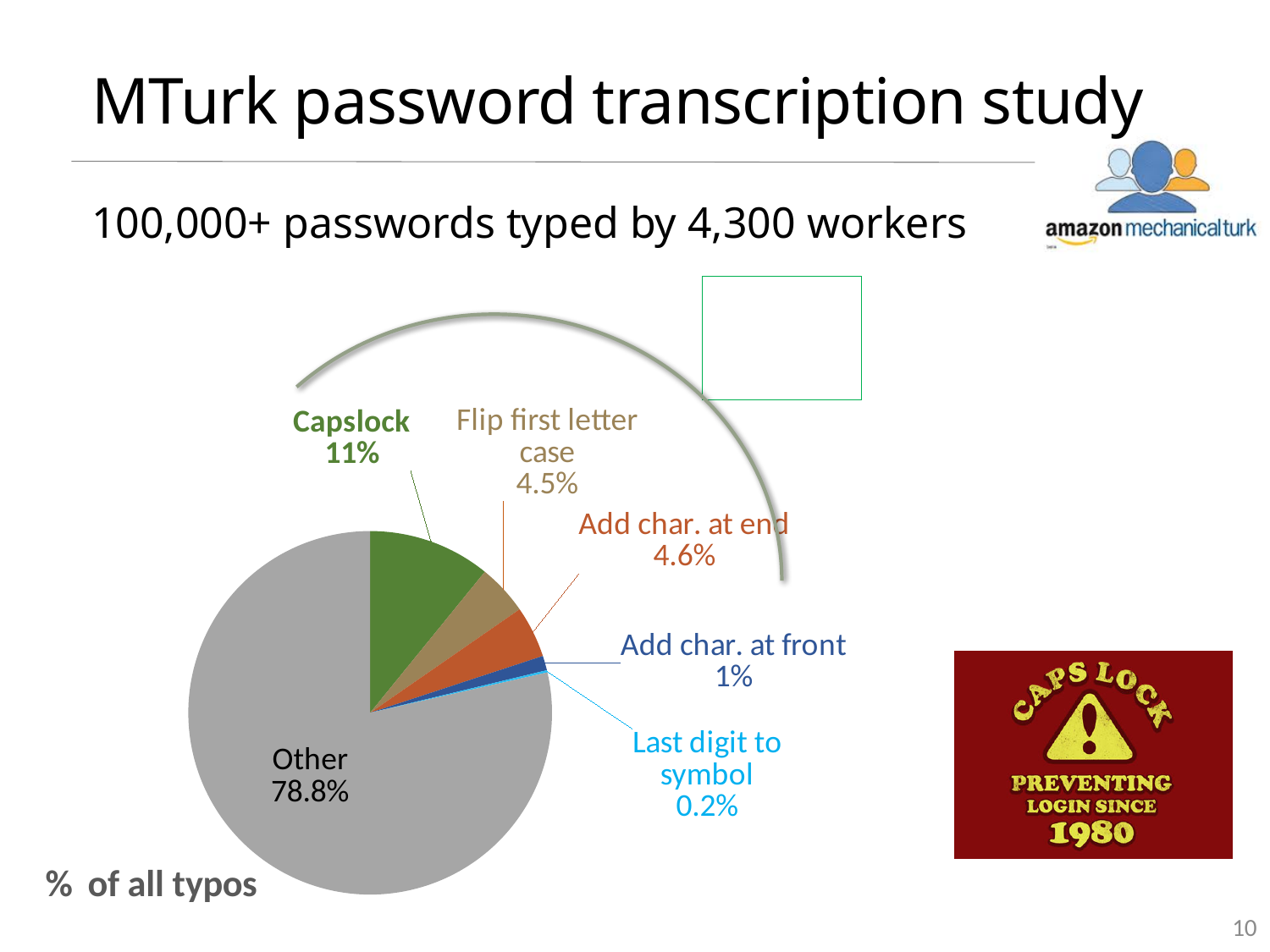
Which is larger, the Capslock slice or the Flip first letter case slice? Capslock Which typo category has the largest slice of the pie? Other What is the difference in percentage points between Capslock and Add char. at end? 6.4 What percentage is shown for Add char. at end? 4.6% Which typo category has the smallest slice of the pie? Last digit to symbol What kind of chart is shown on the slide? Pie chart What percentage is shown for Flip first letter case? 4.5% What share of all typos does the Other slice represent? 78.8% What percentage of typos is Last digit to symbol? 0.2% What does the pie chart measure, according to the label at the bottom left? % of all typos What percentage of all typos is attributed to Capslock in the pie chart? 11% How many slices does the pie chart have? 6